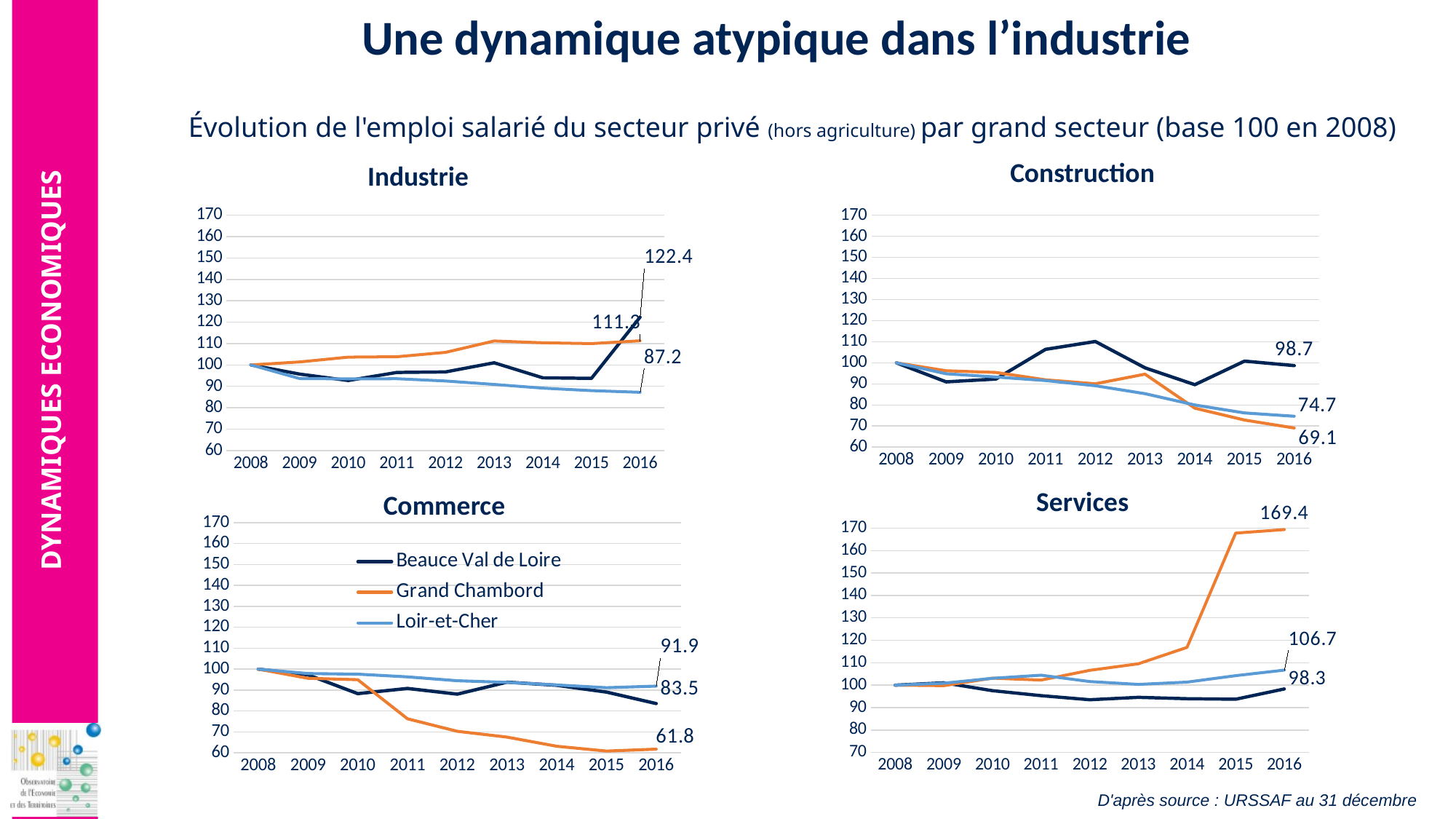
In the Industrie chart, is the 2013 value for Grand Chambord greater or less than 100? greater In the Industrie chart, what is the 2016 value for Beauce Val de Loire? 122.4 In the Services chart, which series has the highest value in 2016? Grand Chambord In the Commerce chart, which series has the lowest value in 2016? Grand Chambord What kind of chart is the Services chart? Line chart In the Commerce chart, does the Grand Chambord line rise or fall from 2008 to 2016? Fall In the Construction chart, what is the 2016 value for Grand Chambord? 69.1 In the Industrie chart, what is the 2016 value for Loir-et-Cher? 87.2 In the Services chart, what is the 2016 value for Grand Chambord? 169.4 In the Construction chart, what is the difference between the 2016 values for Beauce Val de Loire and Loir-et-Cher? 24.0 How many series does the legend list? 3 In the Commerce chart, which is larger in 2016: Loir-et-Cher or Beauce Val de Loire? Loir-et-Cher